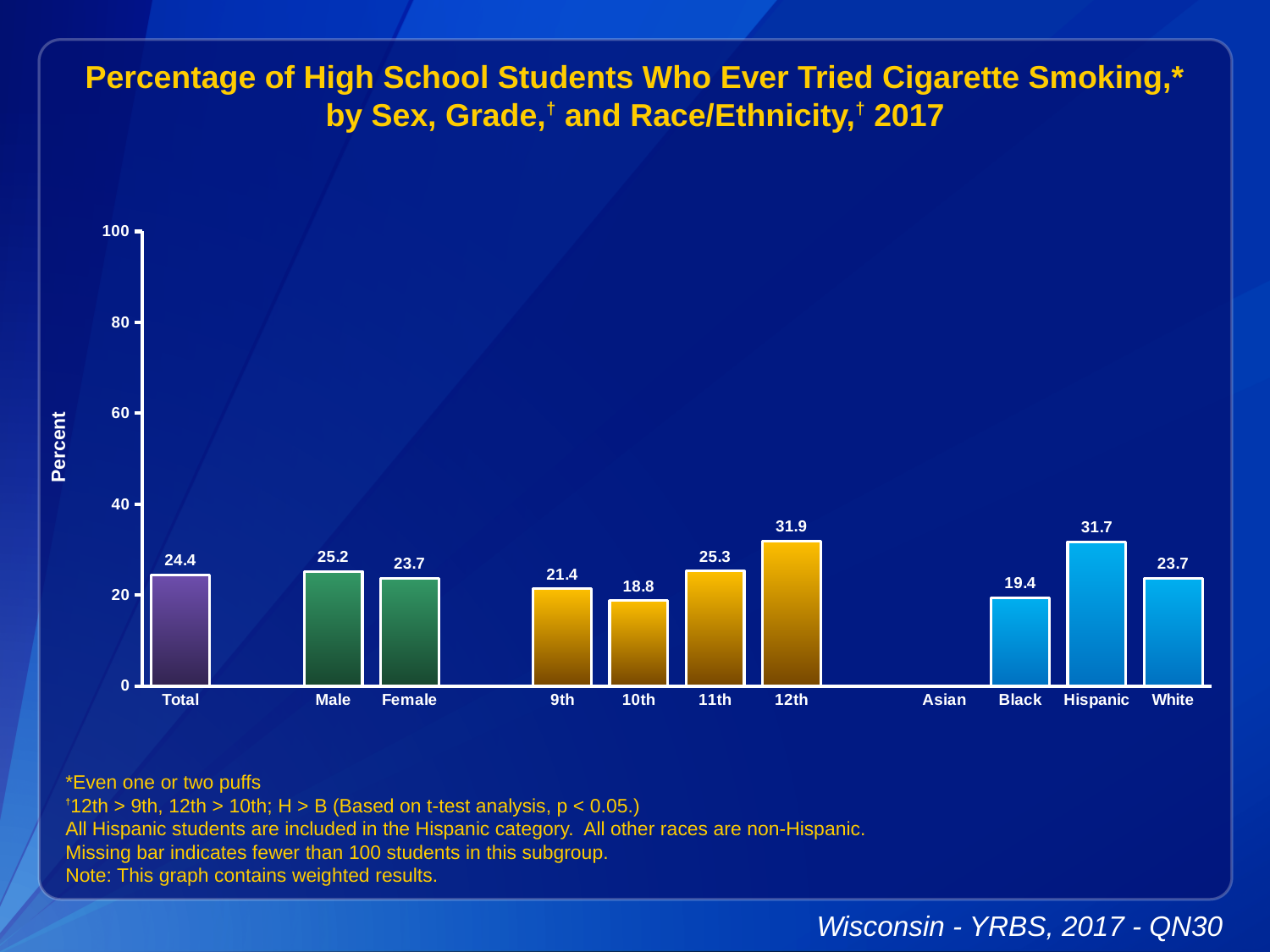
What is the label on the y axis? Percent What is the difference between the Male and Female values? 1.5 Is the value for 12th greater or less than 40? less What is the value for Black students? 19.4 What is the value for Total? 24.4 What percentage of 12th grade students ever tried cigarette smoking? 31.9 Among the grade categories (9th, 10th, 11th, 12th), which has the highest value? 12th What kind of chart is shown on the slide? bar chart Which category has the lowest value on the chart? 10th Which category label has no bar plotted? Asian How many bars are plotted on the chart? 10 Which is larger, the value for Hispanic or the value for White? Hispanic